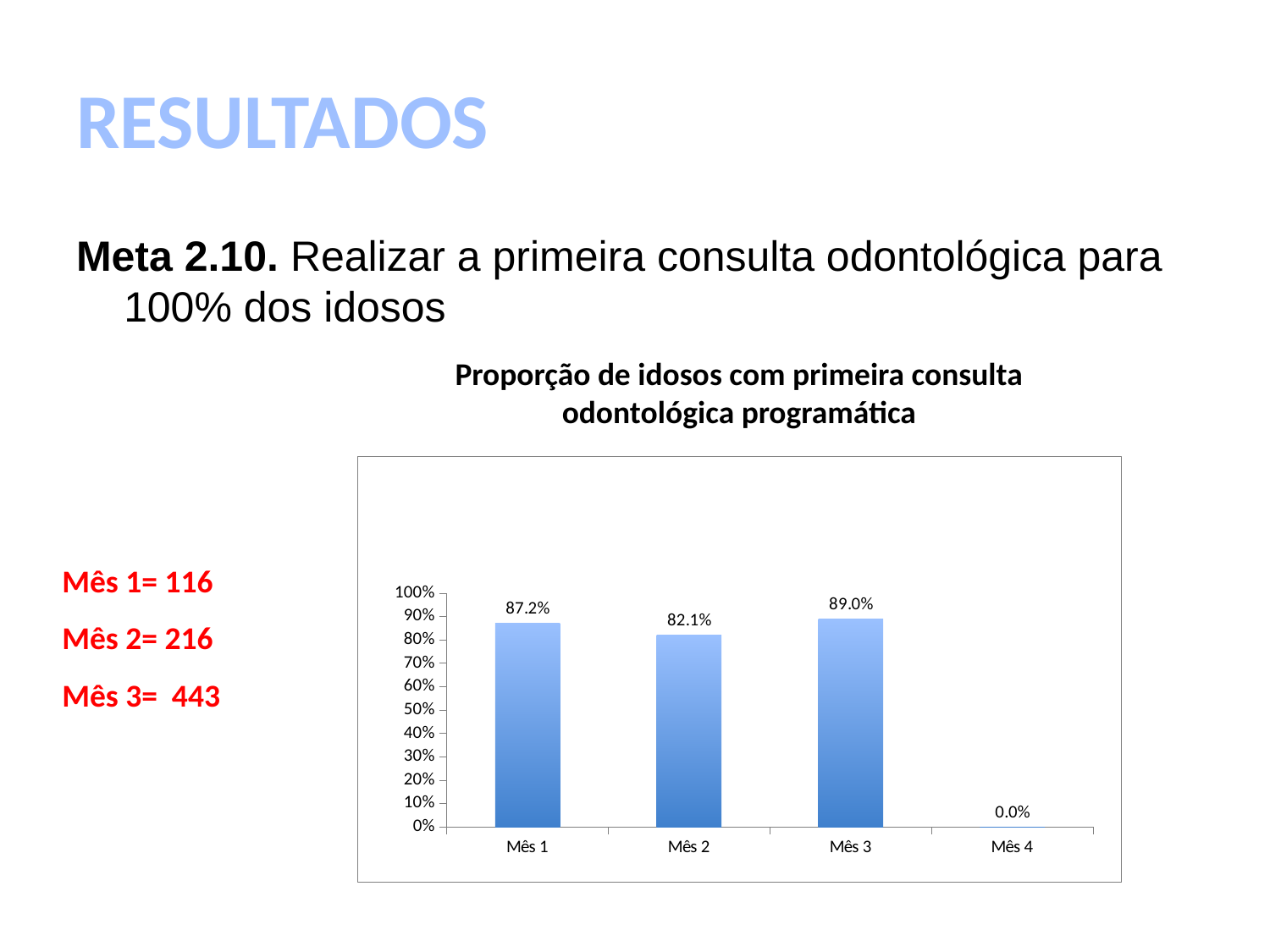
Which month has the lowest value? Mês 4 What is the title of the chart? Proporção de idosos com primeira consulta odontológica programática What is the value for Mês 3? 89.0% What is the value for Mês 1? 87.2% Which is larger, the value for Mês 1 or the value for Mês 2? Mês 1 How many months are shown on the x axis? 4 What is the value for Mês 2? 82.1% Which month has the highest value? Mês 3 What kind of chart is shown? bar chart What is the value for Mês 4? 0.0% What is the difference between the values for Mês 3 and Mês 2? 6.9% Is the value for Mês 2 greater or less than 90%? less